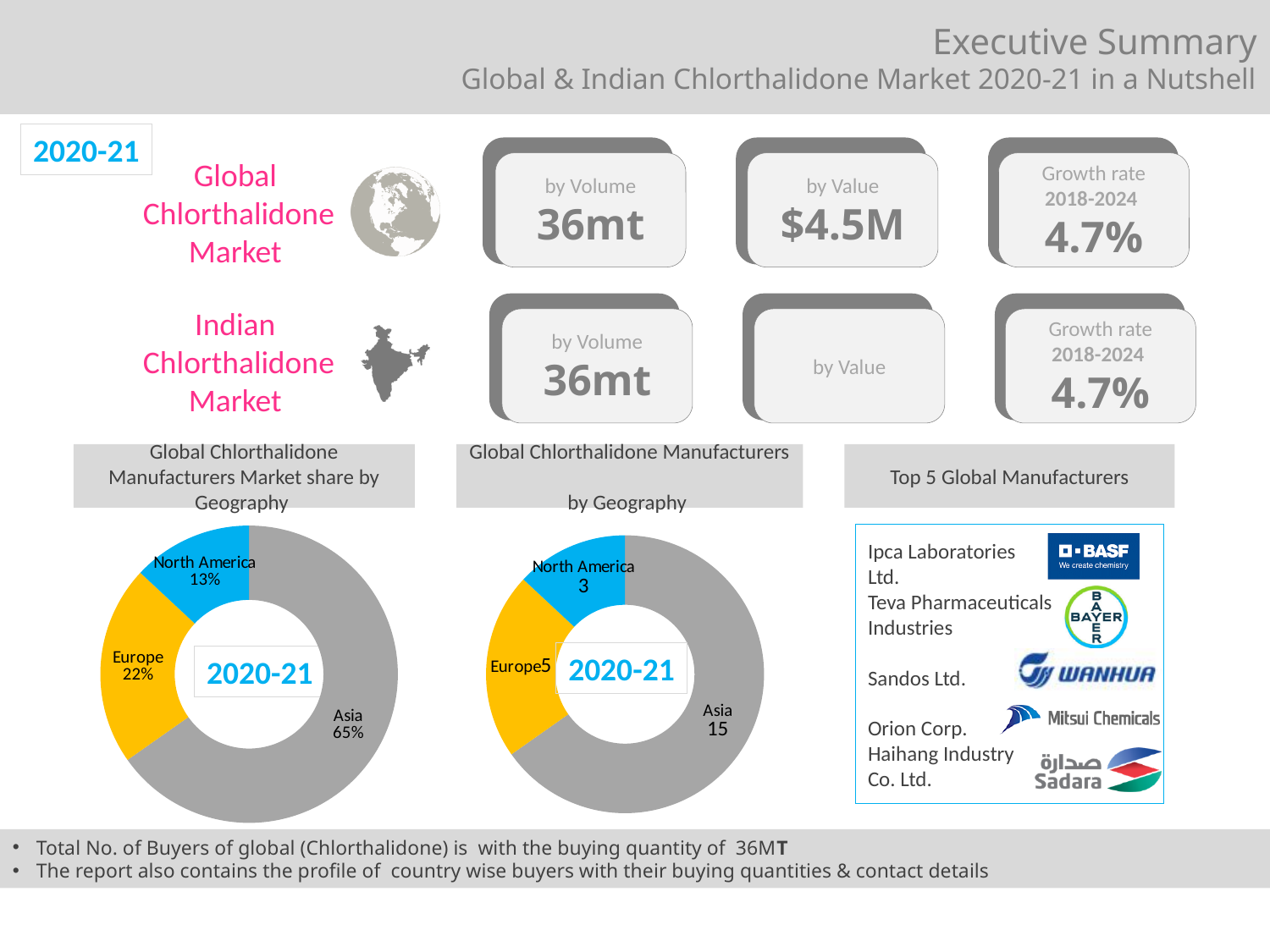
In the 'Global Chlorthalidone Manufacturers by Geography' chart, how many manufacturers are in North America? 3 In the 'Global Chlorthalidone Manufacturers by Geography' chart, which region has the most manufacturers? Asia In the 'Global Chlorthalidone Manufacturers by Geography' chart, how many manufacturers are in Asia? 15 In the 'Global Chlorthalidone Manufacturers Market share by Geography' chart, what is the difference between the shares of Asia and Europe? 43% In the 'Global Chlorthalidone Manufacturers Market share by Geography' chart, which region has the smallest share? North America In the 'Global Chlorthalidone Manufacturers by Geography' chart, which has more manufacturers, Europe or North America? Europe In the 'Global Chlorthalidone Manufacturers Market share by Geography' chart, what is the market share for Asia? 65% What year label is shown in the centre of both donut charts? 2020-21 What kind of chart is the 'Global Chlorthalidone Manufacturers Market share by Geography' chart? Donut (pie) chart In the 'Global Chlorthalidone Manufacturers Market share by Geography' chart, what is the market share for Europe? 22% In the 'Global Chlorthalidone Manufacturers by Geography' chart, what is the difference between the number of manufacturers in Asia and Europe? 10 In the 'Global Chlorthalidone Manufacturers Market share by Geography' chart, how many regions are shown? 3